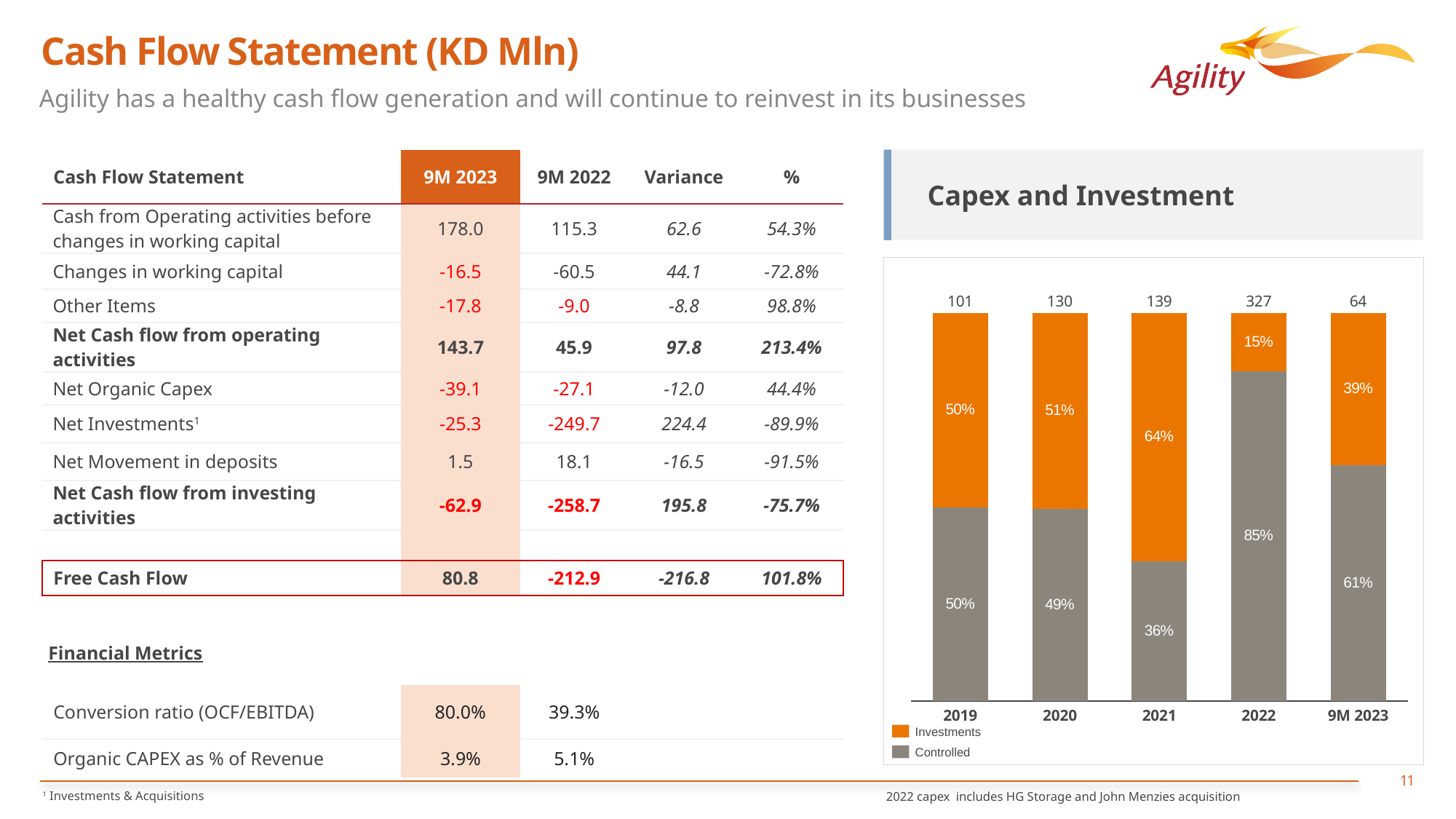
What type of chart is the Capex and Investment chart? Stacked bar chart In the Capex and Investment chart, which colour represents Investments? Orange In the Capex and Investment chart, what is the Controlled percentage for 2019? 50% How many periods are shown on the x axis of the Capex and Investment chart? 5 In the Capex and Investment chart, which period has the lowest total value shown above its bar? 9M 2023 How many series does the legend of the Capex and Investment chart list? 2 In the Capex and Investment chart, what percentage of the 2021 bar is Investments? 64% In the Capex and Investment chart, which year has the highest total value shown above its bar? 2022 In the Capex and Investment chart, what percentage of the 9M 2023 bar is Controlled? 61% In the Capex and Investment chart, which is larger: the Investments share in 2020 or the Investments share in 2022? 2020 In the Capex and Investment chart, what is the difference between the total values for 2022 and 2021? 188 In the Capex and Investment chart, what is the total value shown above the bar for 2022? 327